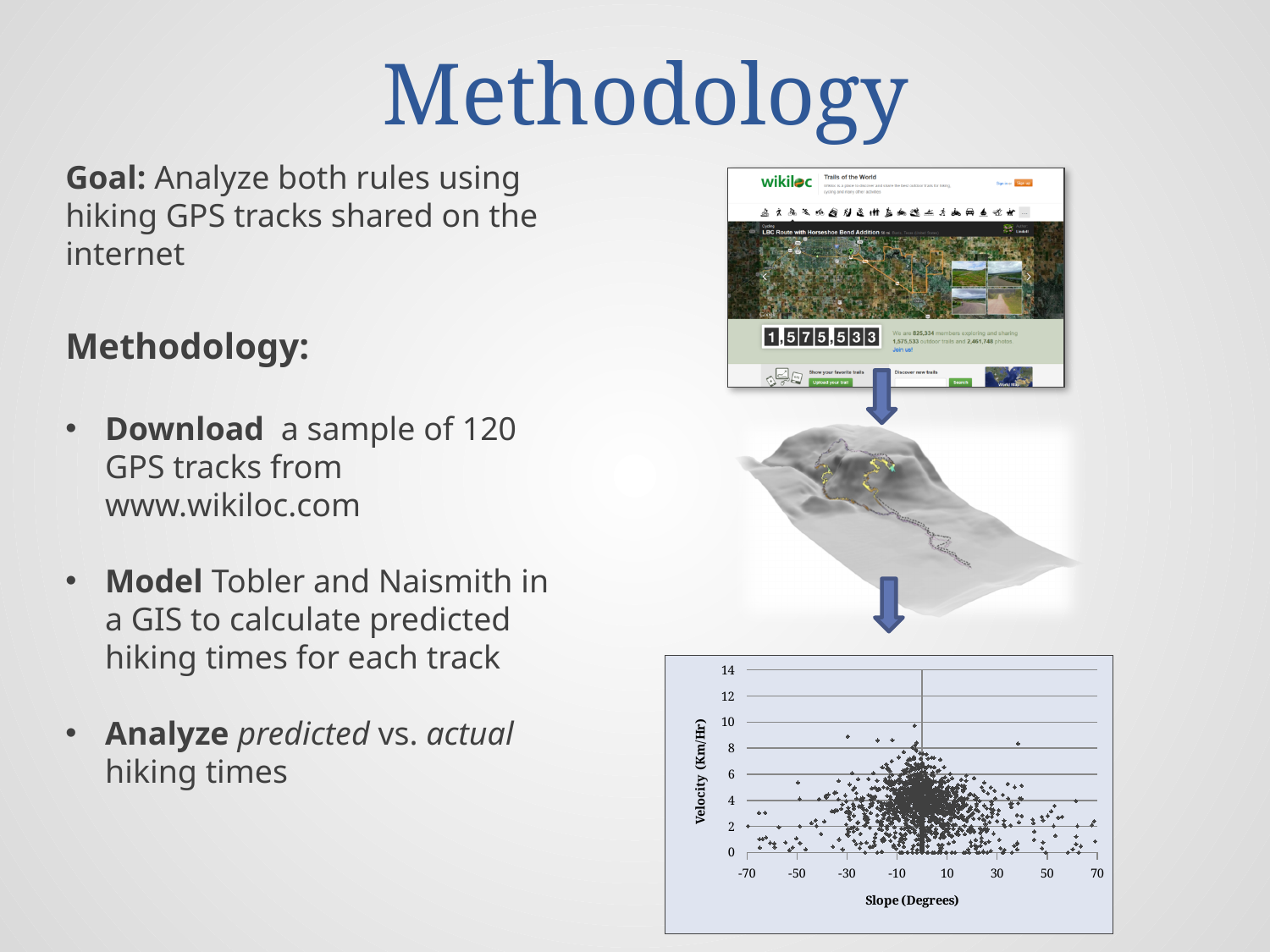
What is the label of the x axis on the scatter plot? Slope (Degrees) What is the label of the y axis on the scatter plot? Velocity (Km/Hr) On the scatter plot, is the highest plotted velocity greater or less than 8? greater What kind of chart is shown at the bottom right of the slide? scatter plot On the scatter plot, is the highest plotted velocity greater or less than 12? less